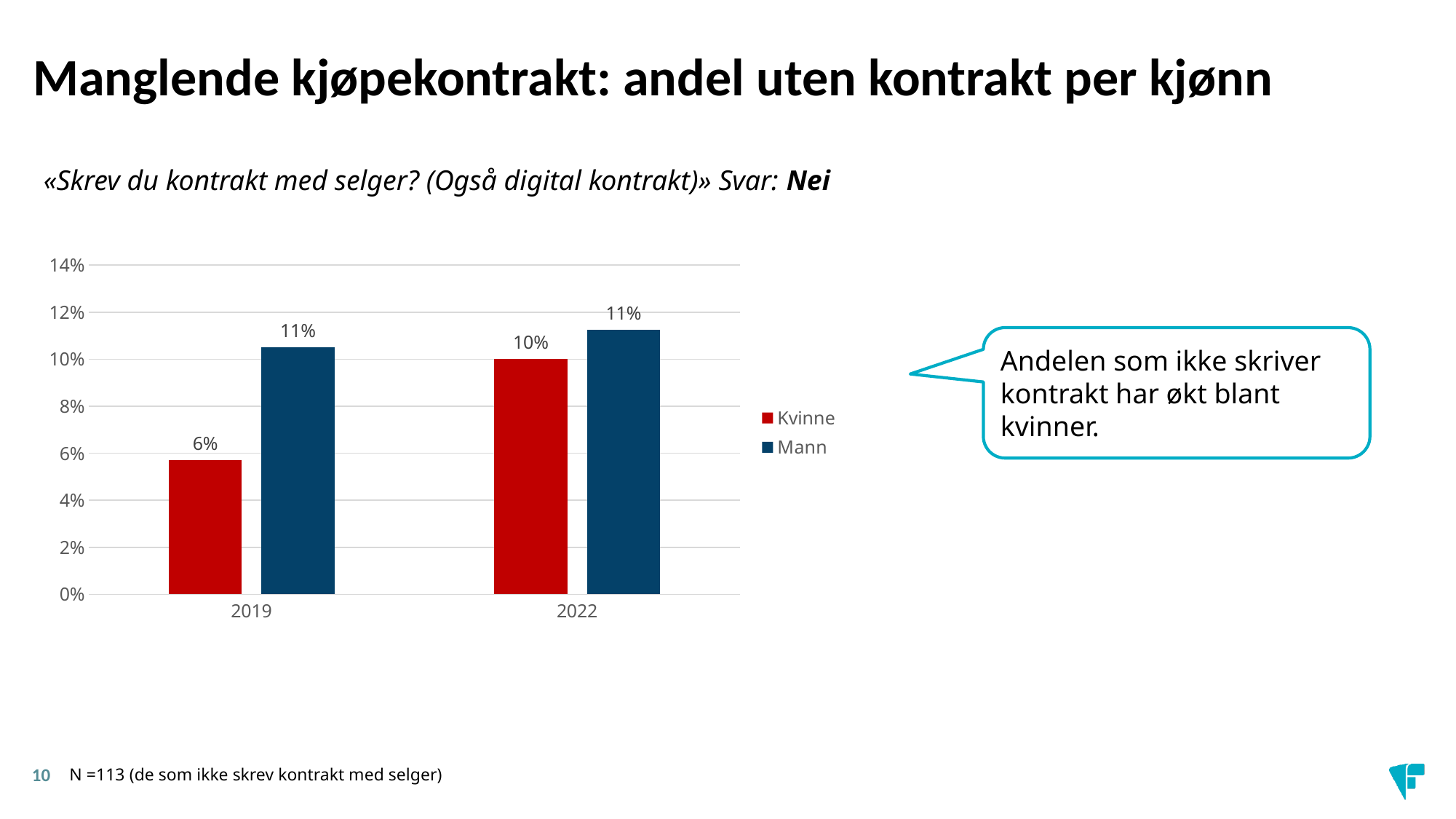
What is the value for Kvinne in 2019? 6% In 2019, which is larger: Kvinne or Mann? Mann What is the value for Kvinne in 2022? 10% How many years are shown on the x axis? 2 Is the value for Kvinne in 2019 greater or less than 8%? less What is the value for Mann in 2019? 11% What is the value for Mann in 2022? 11% What kind of chart is shown on the slide? Bar chart What is the difference between Mann and Kvinne in 2019? 5 percentage points Which bar has the lowest value in the chart? Kvinne in 2019 By how much did the value for Kvinne change from 2019 to 2022? 4 percentage points How many series does the legend list? 2